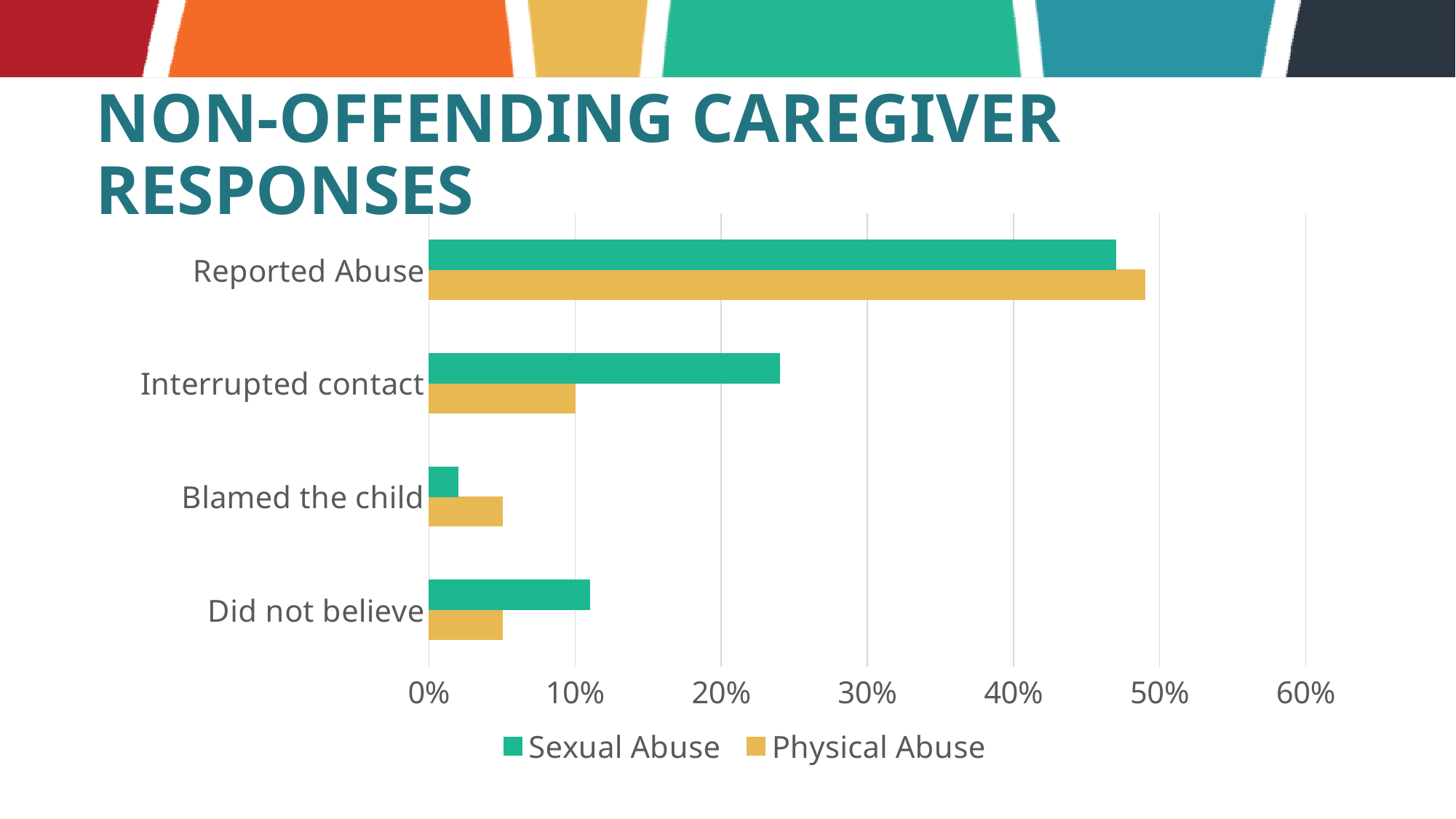
What kind of chart is shown on the slide? bar chart Which category has the highest value for Sexual Abuse? Reported Abuse How many response categories are shown on the chart? 4 What colour are the Physical Abuse bars? yellow Which category has the highest value for Physical Abuse? Reported Abuse Is the Sexual Abuse value for Reported Abuse greater or less than 40%? greater Which category has the lowest value for Sexual Abuse? Blamed the child For Interrupted contact, which series has the larger value, Sexual Abuse or Physical Abuse? Sexual Abuse Is the Sexual Abuse value for Interrupted contact greater or less than 20%? greater For Blamed the child, which series has the larger value, Sexual Abuse or Physical Abuse? Physical Abuse Is the Physical Abuse value for Did not believe greater or less than 10%? less How many series does the legend list? 2